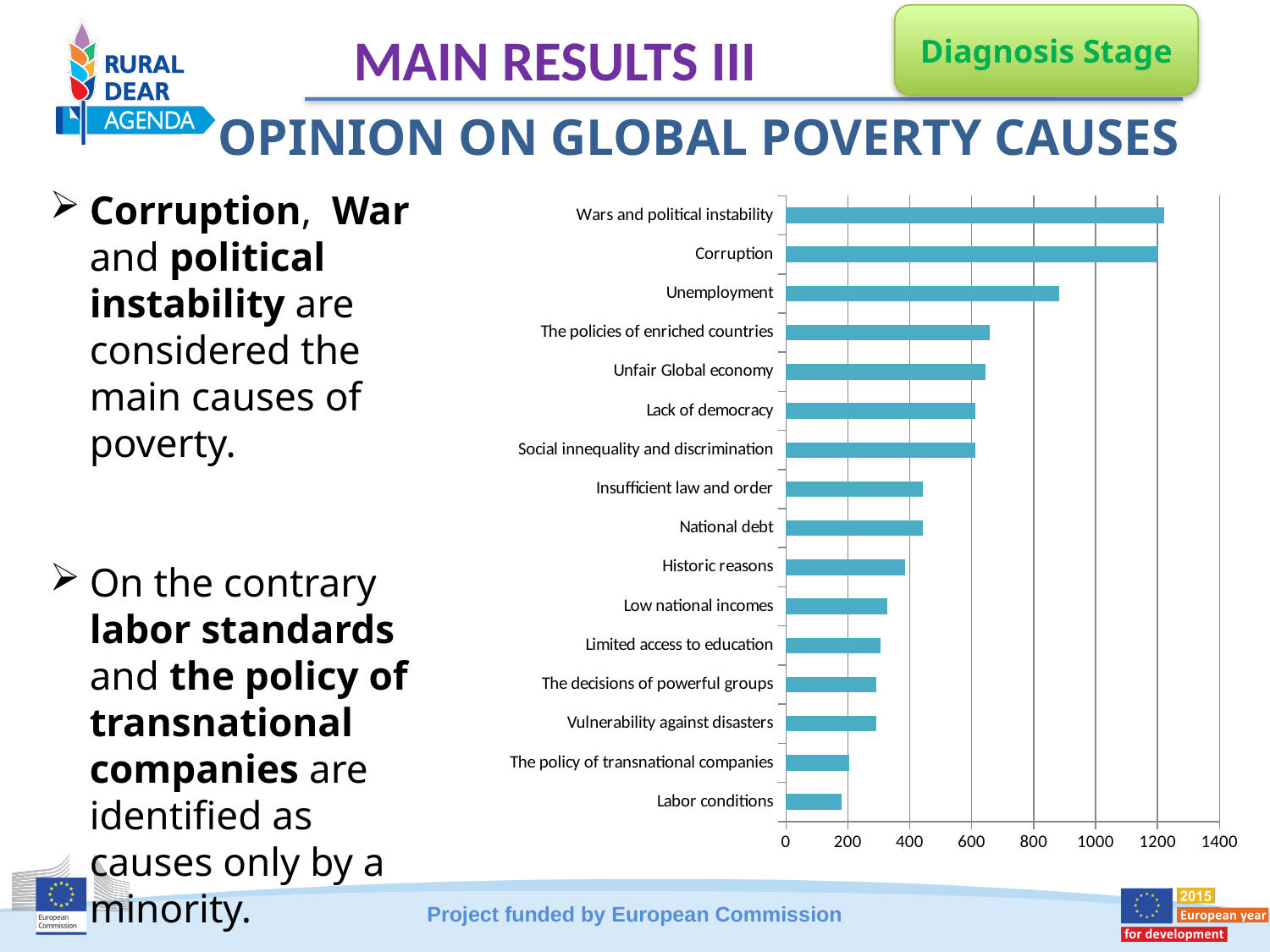
Is the value for Insufficient law and order greater or less than 400? greater Which has the larger value, Corruption or Unemployment? Corruption Is the value for Vulnerability against disasters greater or less than 400? less How many categories (poverty causes) are plotted in the chart? 16 Is the value for Limited access to education greater or less than 200? greater What kind of chart is shown on the slide? bar chart What is the highest value shown on the horizontal axis of the chart? 1400 Which has the larger value, Historic reasons or National debt? National debt What is the title shown above the chart on the slide? OPINION ON GLOBAL POVERTY CAUSES